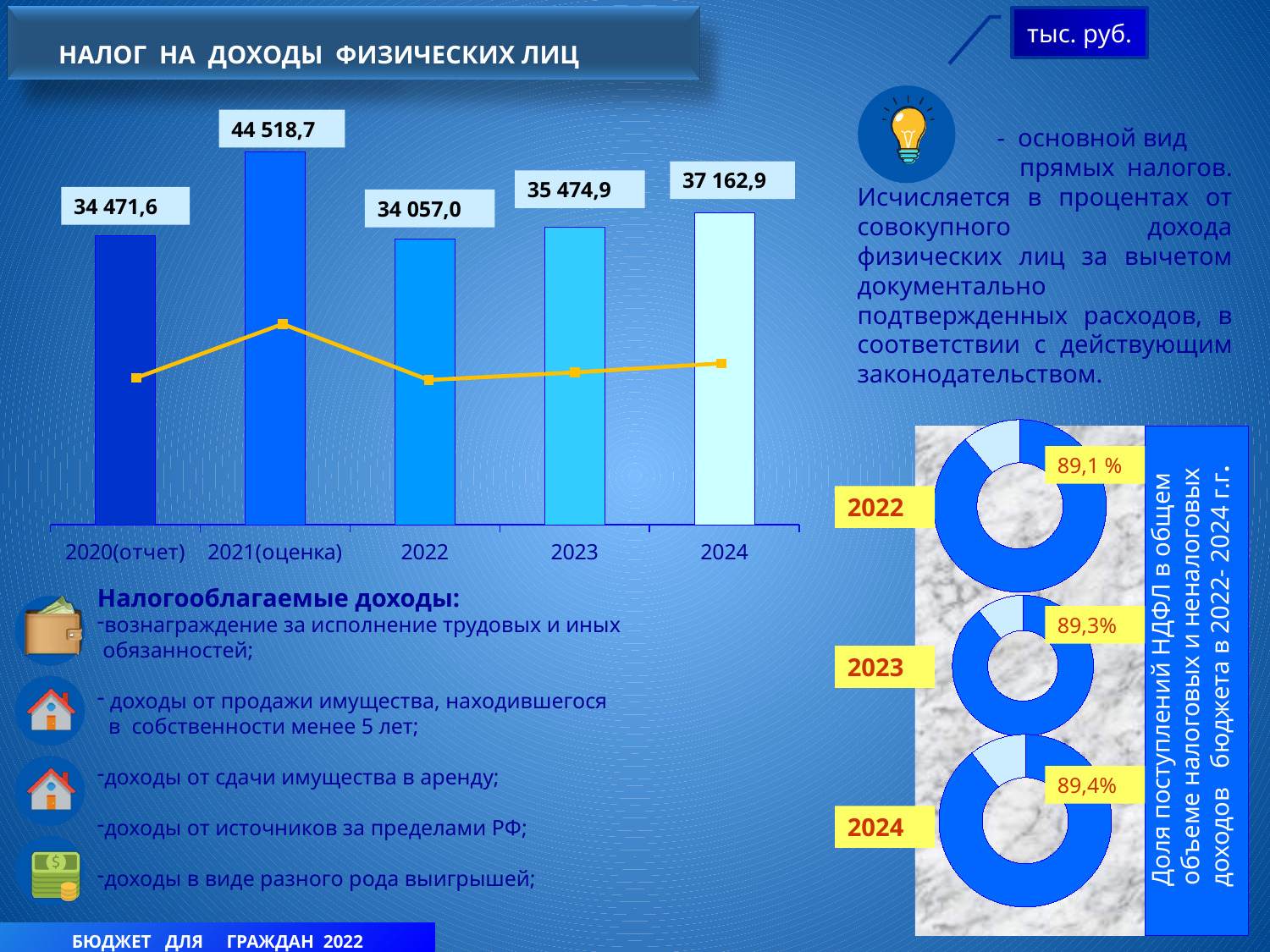
In the doughnut charts on the right, what share is shown for 2022? 89,1 % In the bar chart on the left, what is the difference between the values for 2021(оценка) and 2020(отчет)? 10 047,1 In the bar chart on the left, what is the difference between the values for 2024 and 2023? 1 688,0 In the bar chart on the left, which year has the highest value? 2021(оценка) In the doughnut charts on the right, what share is shown for 2023? 89,3% In the bar chart on the left, do the values rise or fall from 2022 to 2024? rise In the bar chart on the left, which year has the lowest value? 2022 In the bar chart on the left, what is the value for 2024? 37 162,9 In the bar chart on the left, which is larger: the value for 2023 or the value for 2022? 2023 In the bar chart on the left, what is the value for 2020(отчет)? 34 471,6 In the bar chart on the left, what is the value for 2021(оценка)? 44 518,7 How many categories (years) are shown in the bar chart on the left? 5